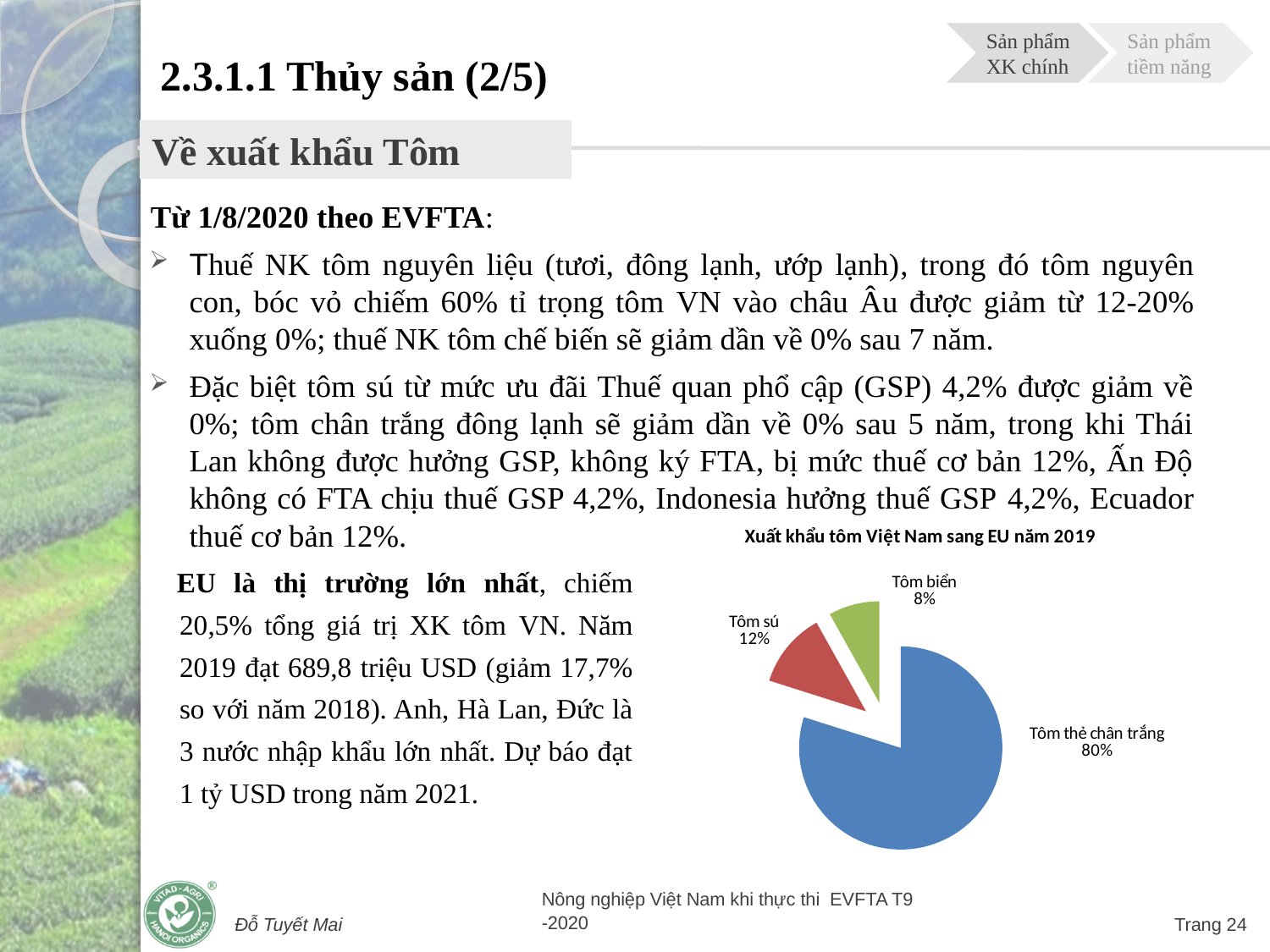
Which category has the largest share of the pie? Tôm thẻ chân trắng Which is larger, the share for Tôm sú or the share for Tôm biển? Tôm sú What colour is the slice for Tôm thẻ chân trắng? blue What is the title of the chart? Xuất khẩu tôm Việt Nam sang EU năm 2019 What share of the pie does Tôm thẻ chân trắng have? 80% What is the difference in percentage points between Tôm sú and Tôm biển? 4% Which category has the smallest share of the pie? Tôm biển What is the difference in percentage points between Tôm thẻ chân trắng and Tôm sú? 68% What type of chart is shown on the slide? pie chart How many categories are shown in the pie chart? 3 What share of the pie does Tôm sú have? 12% What share of the pie does Tôm biển have? 8%